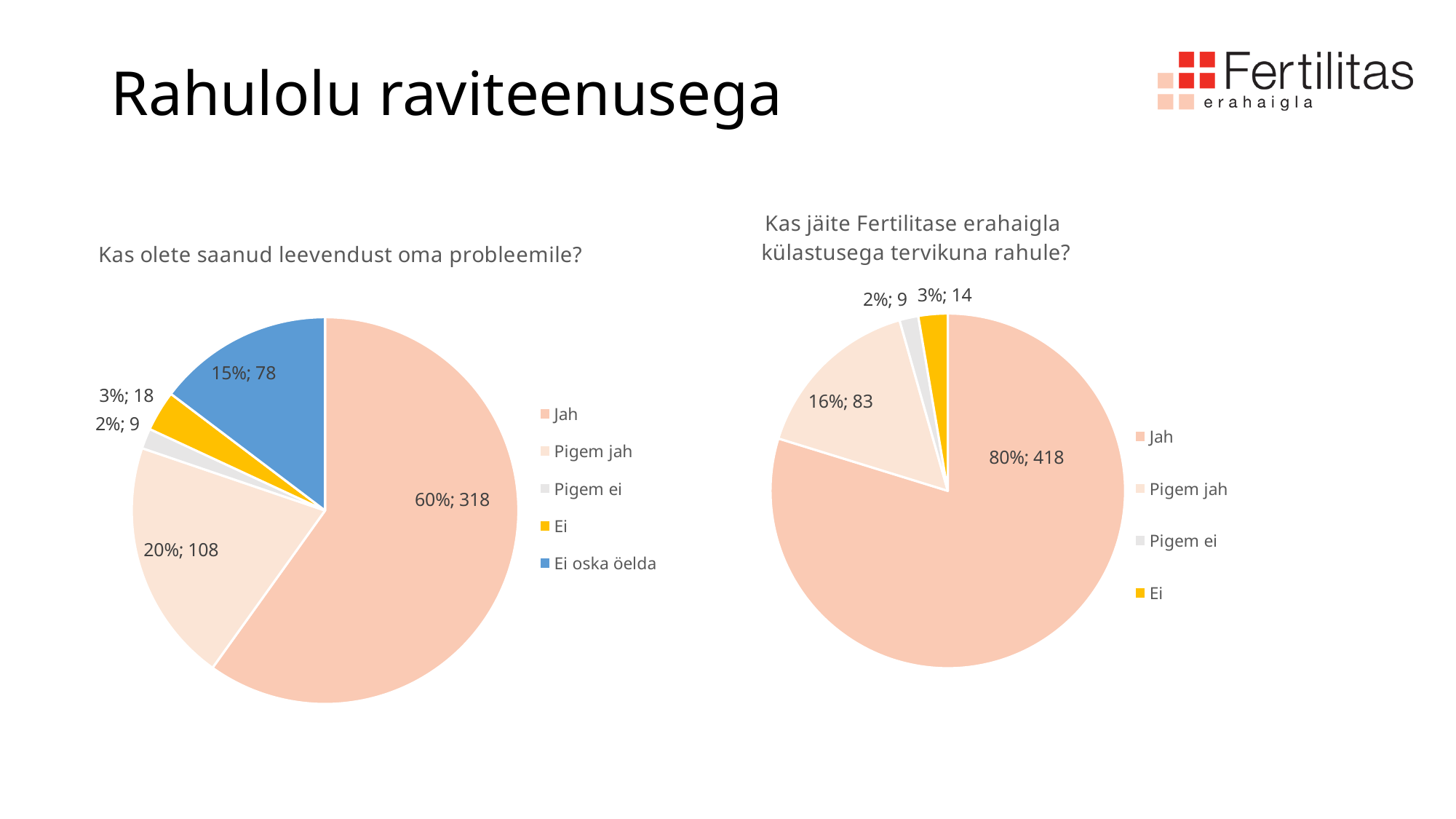
What kind of chart is the left chart, "Kas olete saanud leevendust oma probleemile?"? pie chart In the left chart, "Kas olete saanud leevendust oma probleemile?", what share of the pie is "Jah"? 60% Which chart has the larger "Pigem jah" count, the left chart or the right chart? the left chart In the right chart, "Kas jäite Fertilitase erahaigla külastusega tervikuna rahule?", what share of the pie is "Pigem jah"? 16% In the left chart, "Kas olete saanud leevendust oma probleemile?", which category has the smallest slice? Pigem ei In the right chart, "Kas jäite Fertilitase erahaigla külastusega tervikuna rahule?", which category has the largest slice? Jah In the left chart, "Kas olete saanud leevendust oma probleemile?", what is the count shown for "Ei oska öelda"? 78 What is the difference between the "Jah" count in the right chart (418) and the "Jah" count in the left chart (318)? 100 In the left chart, "Kas olete saanud leevendust oma probleemile?", what is the count shown for "Pigem jah"? 108 How many categories does the legend of the left chart, "Kas olete saanud leevendust oma probleemile?", list? 5 In the right chart, "Kas jäite Fertilitase erahaigla külastusega tervikuna rahule?", what is the count shown for "Ei"? 14 In the right chart, "Kas jäite Fertilitase erahaigla külastusega tervikuna rahule?", what is the count shown for "Jah"? 418